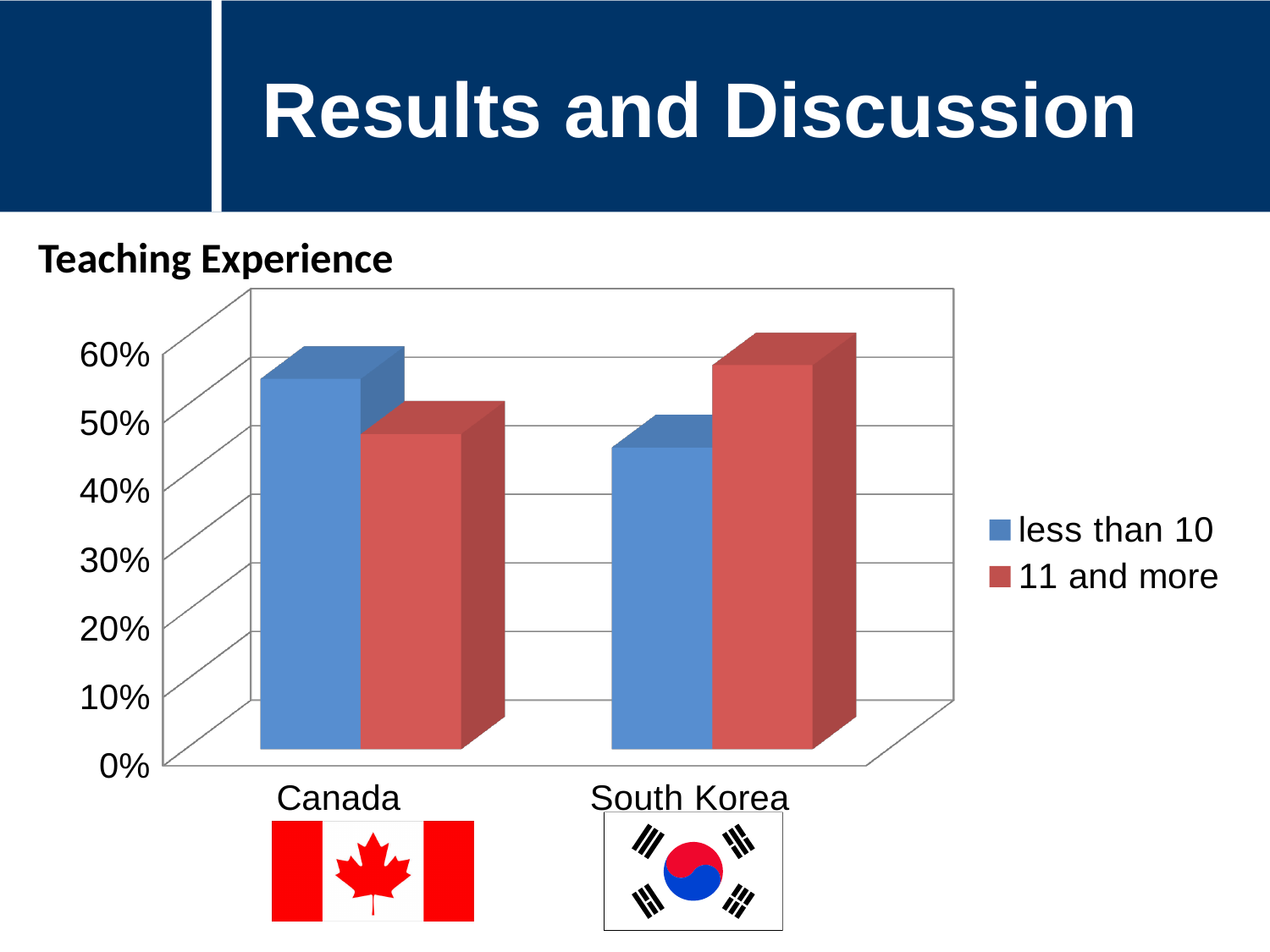
Is the value for '11 and more' in South Korea greater or less than 50%? greater What kind of chart is shown on the slide? bar chart How many series does the legend list? 2 What is the title of the chart? Teaching Experience For Canada, which series has the larger value, 'less than 10' or '11 and more'? less than 10 Is the value for 'less than 10' in South Korea greater or less than 50%? less How many categories are shown on the x axis? 2 Which series is shown in red? 11 and more Which category has the higher value for the 'less than 10' series? Canada Is the value for 'less than 10' in Canada greater or less than 50%? greater For South Korea, which series has the larger value, 'less than 10' or '11 and more'? 11 and more